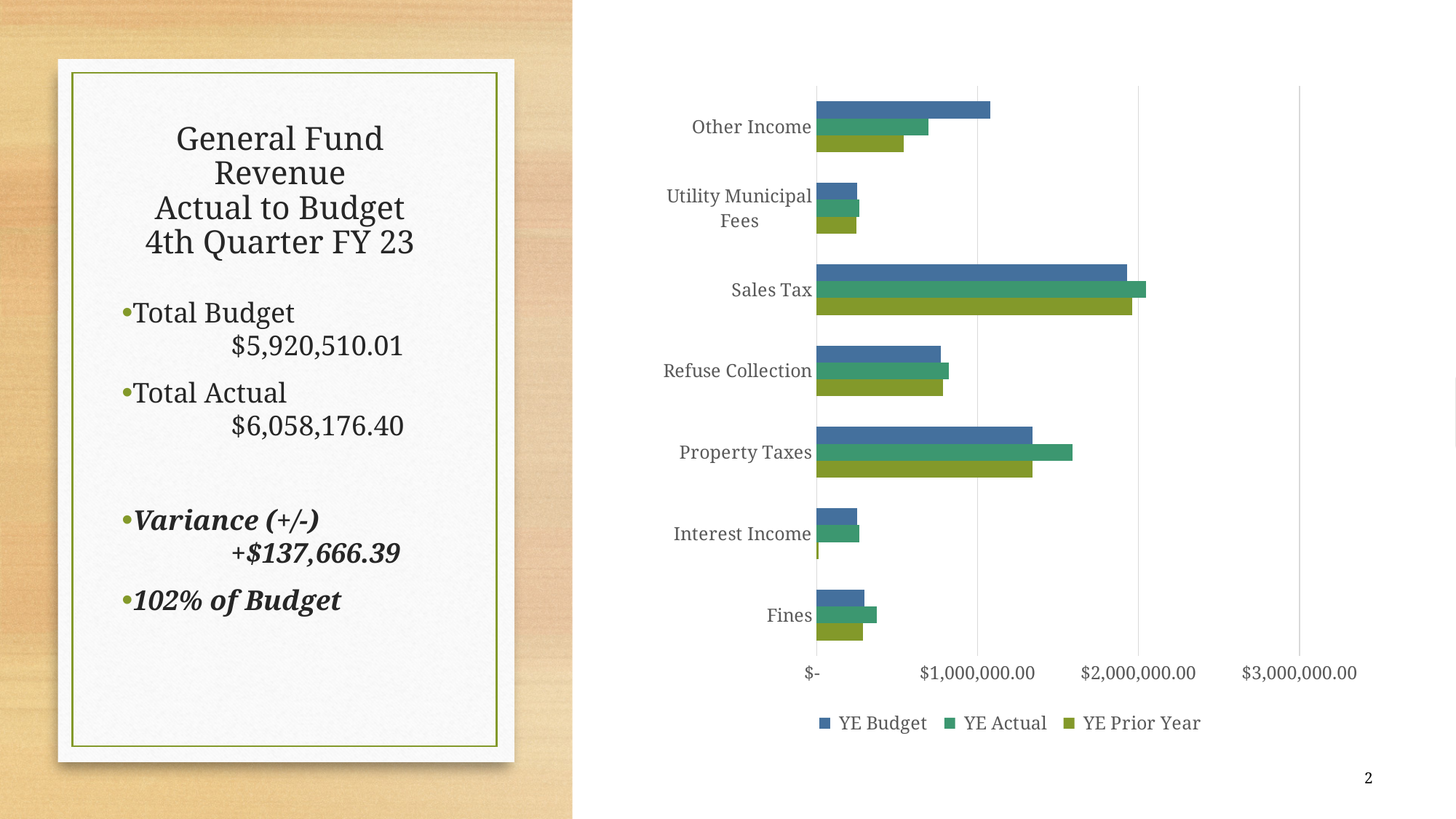
How many series does the chart legend list? 3 What are the three series listed in the chart legend? YE Budget, YE Actual, YE Prior Year Is the YE Budget value for Fines greater or less than $1,000,000.00? less How many categories are shown on the chart? 7 For Property Taxes, which is larger: YE Budget or YE Actual? YE Actual Which category has the highest YE Actual value? Sales Tax Which has the larger YE Budget value: Sales Tax or Property Taxes? Sales Tax Is the YE Prior Year value for Sales Tax greater or less than $3,000,000.00? less Which category has the lowest YE Prior Year value? Interest Income Is the YE Actual value for Refuse Collection greater or less than $1,000,000.00? less What kind of chart is shown on the slide? bar chart